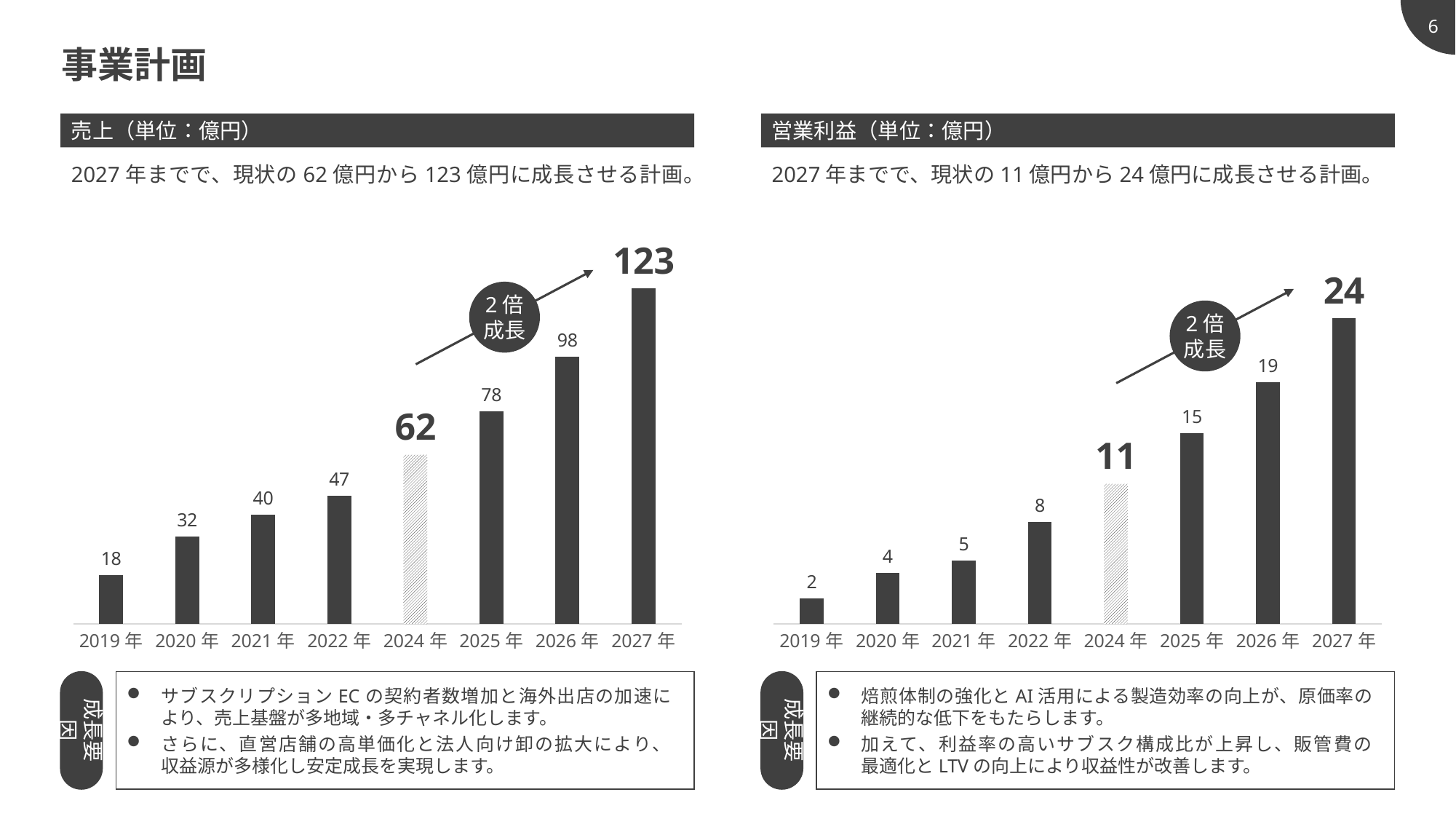
In the 営業利益（単位：億円） chart, what is the value for 2026 年? 19 What kind of chart is the 売上（単位：億円） chart? bar chart In the 営業利益（単位：億円） chart, which year has the highest value? 2027 年 In the 売上（単位：億円） chart, which is larger, the value for 2022 年 or the value for 2025 年? 2025 年 In the 売上（単位：億円） chart, what is the value for 2019 年? 18 In the 売上（単位：億円） chart, what is the value for 2024 年? 62 In the 営業利益（単位：億円） chart, do the values rise or fall from 2019 年 to 2027 年? rise In the 売上（単位：億円） chart, which year has the lowest value? 2019 年 In the 売上（単位：億円） chart, what is the difference between the values for 2027 年 and 2024 年? 61 How many years are shown on the x axis of the 営業利益（単位：億円） chart? 8 In the 営業利益（単位：億円） chart, what is the difference between the values for 2025 年 and 2022 年? 7 In the 売上（単位：億円） chart, what does the circle label between 2024 年 and 2027 年 say? 2 倍成長